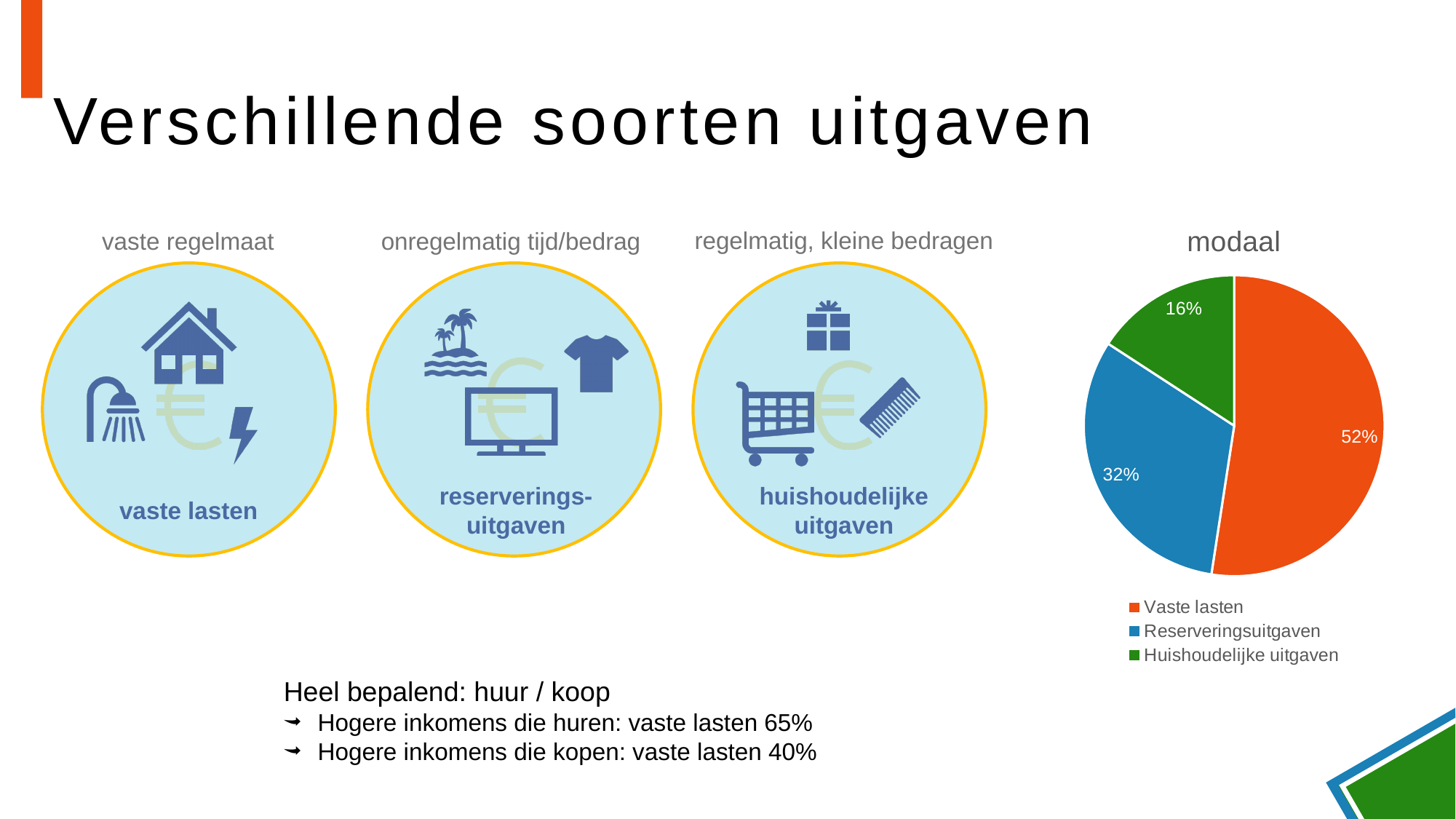
Which colour represents Reserveringsuitgaven in the pie chart? blue What share of the pie does Huishoudelijke uitgaven take? 16% What is the difference in percentage points between Reserveringsuitgaven and Huishoudelijke uitgaven? 16 Which category has the smallest slice of the pie? Huishoudelijke uitgaven What kind of chart is shown on the slide? pie chart What is the title of the pie chart? modaal How many slices does the pie chart have? 3 Which is larger, Reserveringsuitgaven or Huishoudelijke uitgaven? Reserveringsuitgaven Which category has the largest slice of the pie? Vaste lasten What share of the pie does Vaste lasten take? 52% What share of the pie does Reserveringsuitgaven take? 32% What is the difference in percentage points between Vaste lasten and Reserveringsuitgaven? 20